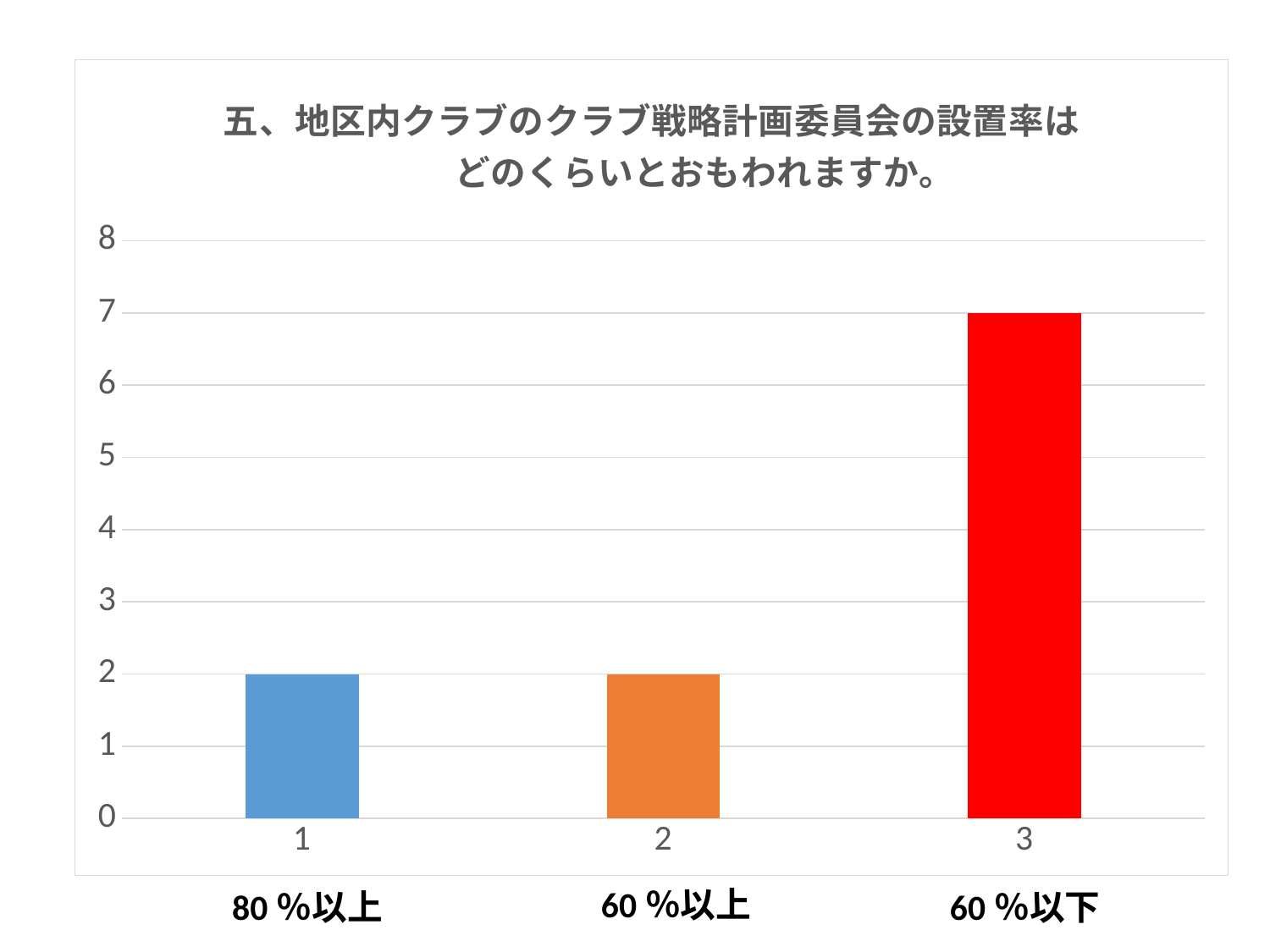
What is the value for category 2 (60％以上)? 2 What is the difference between the values for category 3 and category 1? 5 What is the highest value shown on the y axis? 8 Which is larger, the value for category 3 or the value for category 2? Category 3 Is the value for category 1 greater or less than 4? less What kind of chart is shown on the slide? Bar chart Is the value for category 3 greater or less than 6? greater What is the value for category 3 (60％以下)? 7 How many categories are shown on the x axis? 3 Which category has the highest value? 3 (60％以下) What is the value for category 1 (80％以上)? 2 What colour is the bar for category 3? Red